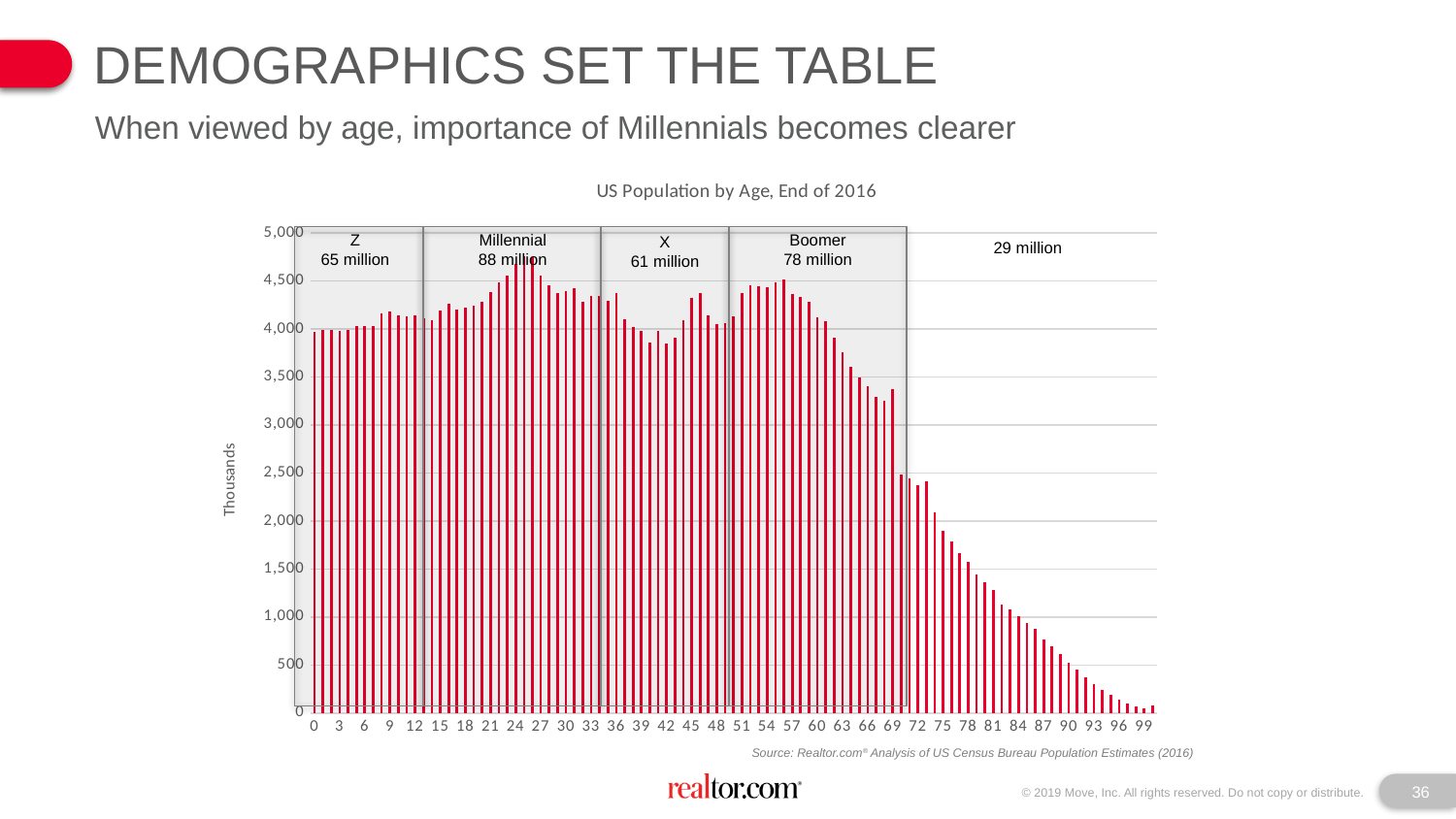
According to the chart annotation, what is the population of the Boomer generation? 78 million Among the generations labeled Z, Millennial, X and Boomer, which has the largest population? Millennial What is the title of the chart? US Population by Age, End of 2016 Is the value for age 24 greater or less than 4,500? greater What kind of chart is shown on the slide? bar chart Do the values rise or fall along the x axis from age 72 to age 99? fall What unit is shown on the y-axis label of the chart? Thousands According to the chart annotation, what is the population of the Millennial generation? 88 million Is the value for age 87 greater or less than 1,000? less Among the generations labeled Z, Millennial, X and Boomer, which has the smallest population? X How many million more people are in the Millennial generation than in the Boomer generation, according to the annotations? 10 million According to the chart annotation, what is the population of Generation Z? 65 million